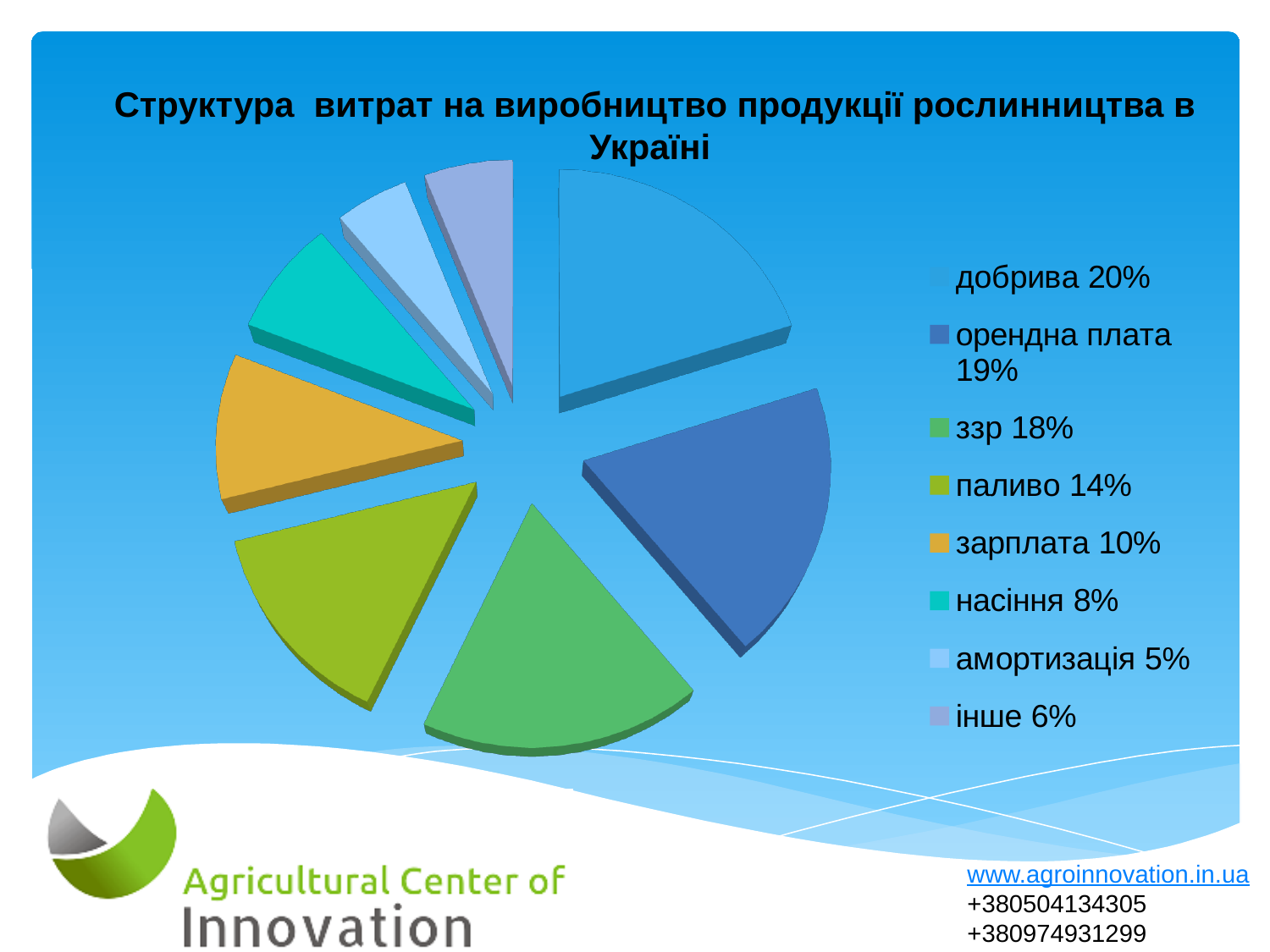
What percentage is shown for орендна плата? 19% What share is shown for насіння? 8% What share of costs does добрива account for? 20% What is the title of the chart? Структура витрат на виробництво продукції рослинництва в Україні What is the combined share of добрива and орендна плата? 39% Which category has the largest share of the pie? добрива What percentage is shown for паливо? 14% Which category has the smallest share of the pie? амортизація Which is larger, the share for інше or the share for амортизація? інше How many categories does the pie chart have? 8 What is the difference in percentage points between ззр and зарплата? 8 What kind of chart is shown on the slide? pie chart